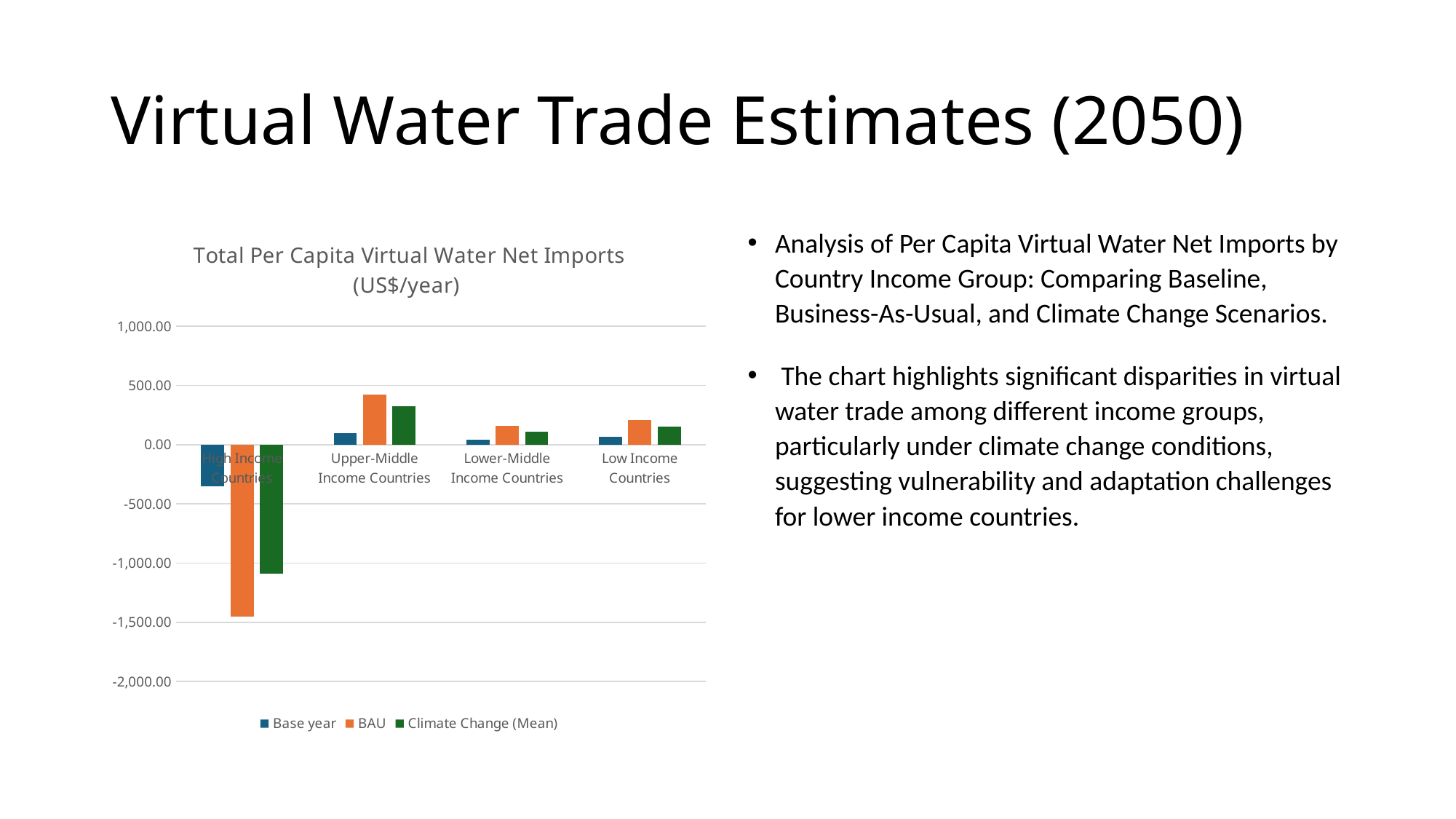
Is the BAU value for High Income Countries greater or less than -1,000.00? less How many series does the chart legend list? 3 What kind of chart is shown on the slide? bar chart Which country income group has the highest BAU value? Upper-Middle Income Countries How many country income groups are shown on the x axis of the chart? 4 Which series is shown in orange in the chart? BAU Is the Climate Change (Mean) value for High Income Countries greater or less than -500.00? less Which country income group has the lowest BAU value? High Income Countries For Upper-Middle Income Countries, which is larger: the BAU value or the Climate Change (Mean) value? BAU Which country income group is the only one with negative values for all three series? High Income Countries What is the title of the chart? Total Per Capita Virtual Water Net Imports (US$/year) Is the BAU value for Upper-Middle Income Countries greater or less than 500.00? less